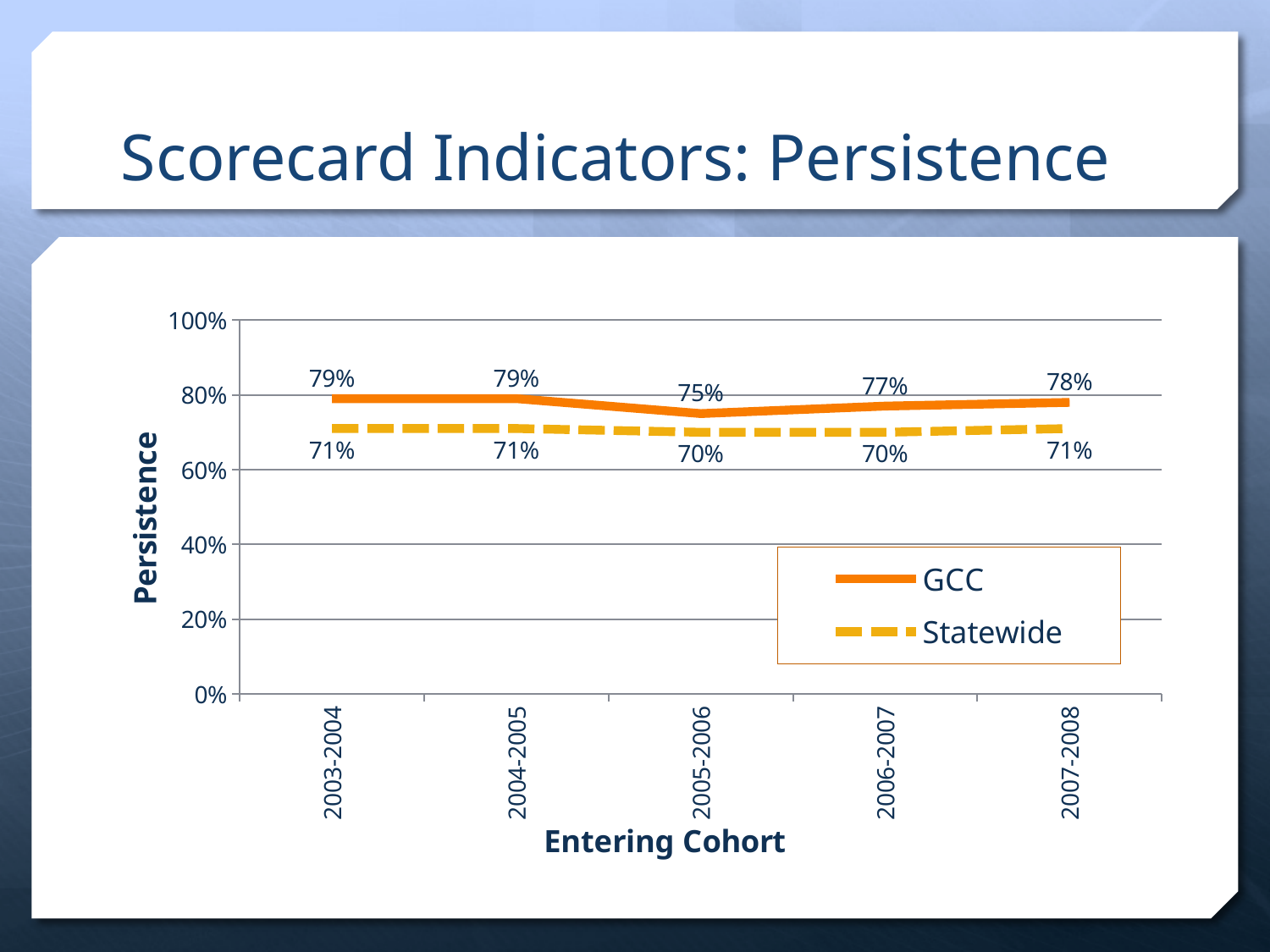
What kind of chart is shown on the slide? Line chart Which is larger for the 2007-2008 cohort, the GCC value or the Statewide value? GCC What is the difference between the GCC persistence values for 2004-2005 and 2005-2006? 4% How many series does the legend list? 2 How many entering cohorts are shown on the x axis? 5 What is the GCC persistence value for the 2003-2004 entering cohort? 79% What is the difference between the GCC and Statewide persistence values for the 2006-2007 cohort? 7% Does the GCC persistence value rise or fall from the 2005-2006 cohort to the 2007-2008 cohort? Rise What is the GCC persistence value for the 2005-2006 entering cohort? 75% Which entering cohort has the lowest GCC persistence value? 2005-2006 What is the label of the y axis? Persistence What is the Statewide persistence value for the 2007-2008 entering cohort? 71%